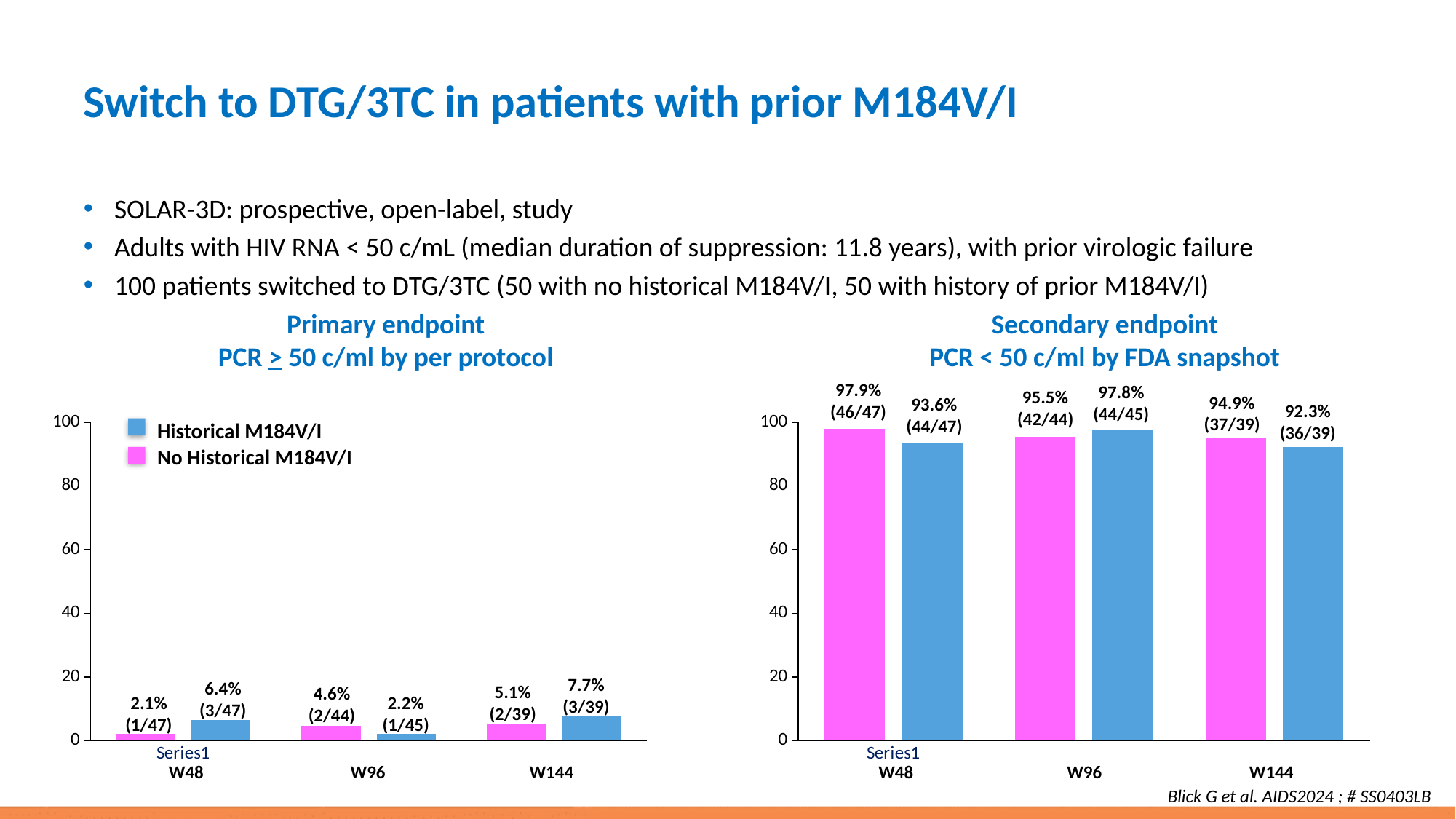
In the Secondary endpoint chart, which bar has the lowest value? Historical M184V/I at W144 How many time points are shown on the x axis of the Primary endpoint chart? 3 In the Secondary endpoint chart, what is the value for Historical M184V/I at W144? 92.3% In the Secondary endpoint chart, what is the value for No Historical M184V/I at W48? 97.9% In the Primary endpoint chart, what is the value for Historical M184V/I at W48? 6.4% What type of chart is the Secondary endpoint chart? Bar chart In the Primary endpoint chart, what is the difference between Historical M184V/I and No Historical M184V/I at W144? 2.6% In the Primary endpoint chart, which bar has the highest value? Historical M184V/I at W144 In the Secondary endpoint chart, is the value for Historical M184V/I at W48 greater or less than 80? greater In the Secondary endpoint chart, which is larger at W96: Historical M184V/I or No Historical M184V/I? Historical M184V/I How many series does the legend of the Primary endpoint chart list? 2 In the Primary endpoint chart, what is the value for No Historical M184V/I at W96? 4.6%